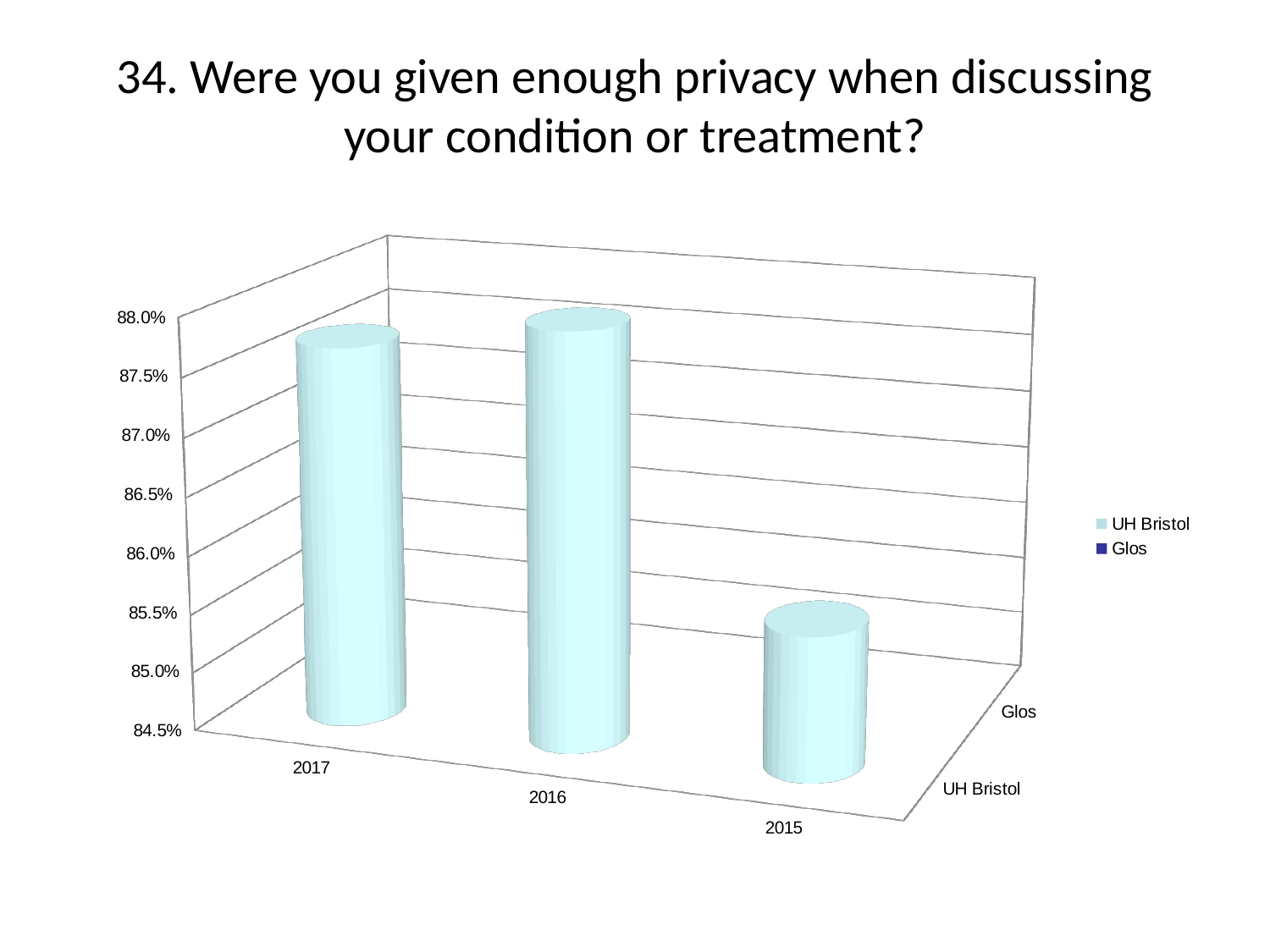
Is the UH Bristol value for 2017 greater or less than 86.0%? greater What kind of chart is shown on the slide? bar chart How many year categories are shown on the x axis? 3 Is the UH Bristol value for 2015 greater or less than 87.0%? less What are the two series names listed in the legend? UH Bristol and Glos Which is larger for UH Bristol, the value for 2017 or the value for 2015? 2017 Which is larger for UH Bristol, the value for 2016 or the value for 2015? 2016 What is the title of the chart on the slide? 34. Were you given enough privacy when discussing your condition or treatment? Which year has the lowest value for UH Bristol? 2015 Is the UH Bristol value for 2016 greater or less than 86.5%? greater How many series does the legend list? 2